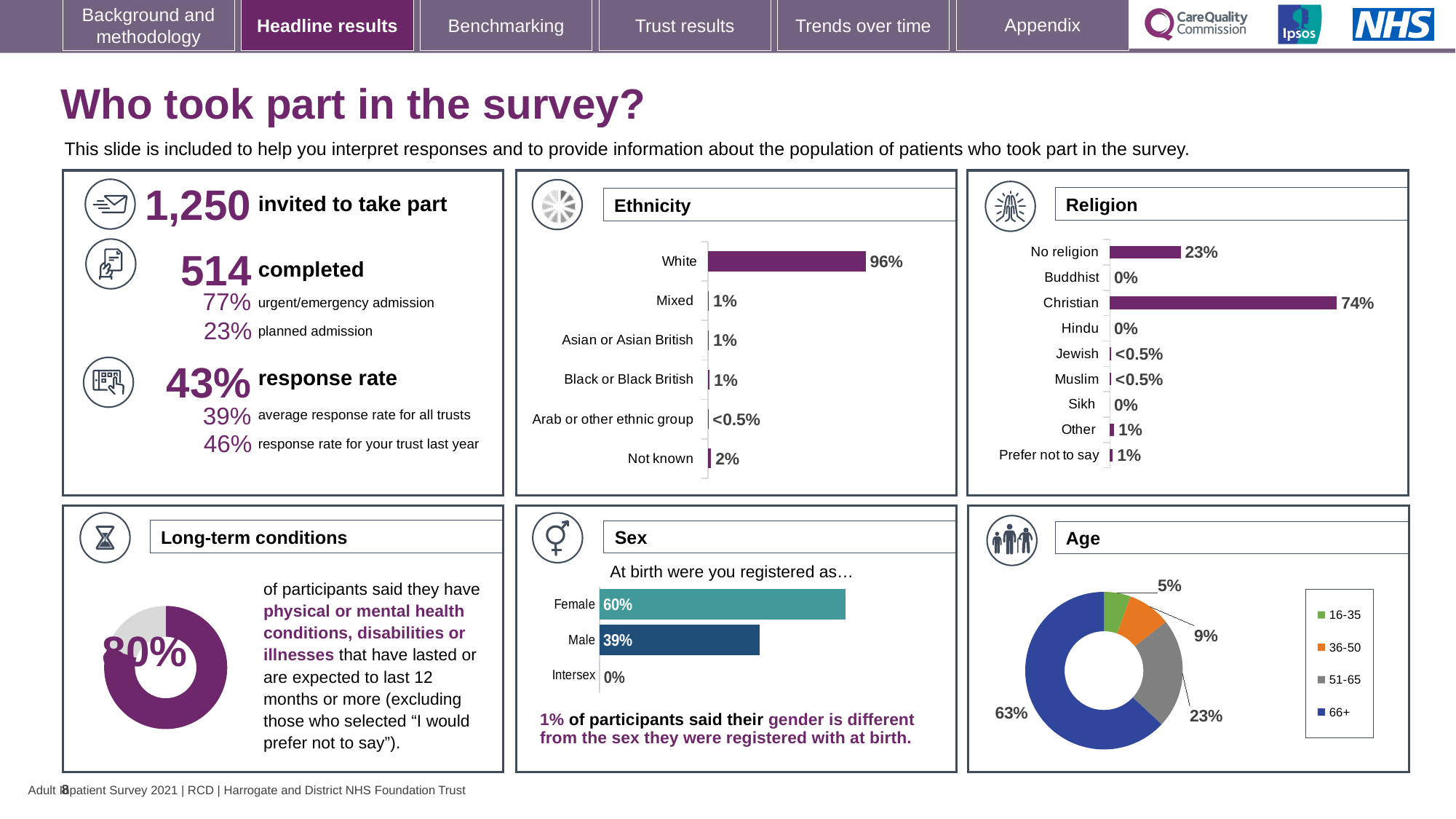
In the Religion chart, what is the value for No religion? 23% In the Ethnicity chart, what is the value for White? 96% In the Age chart, what share of the donut is 66+? 63% In the Ethnicity chart, how many categories are shown? 6 In the Ethnicity chart, which category has the highest value? White In the Religion chart, how many categories are shown? 9 In the Religion chart, what is the difference between Christian and No religion? 51% In the Ethnicity chart, what is the value for Not known? 2% In the Sex chart, what is the value for Female? 60% In the Age chart, how many age groups does the legend list? 4 In the Religion chart, what is the value for Christian? 74% In the Sex chart, which is larger, Female or Male? Female